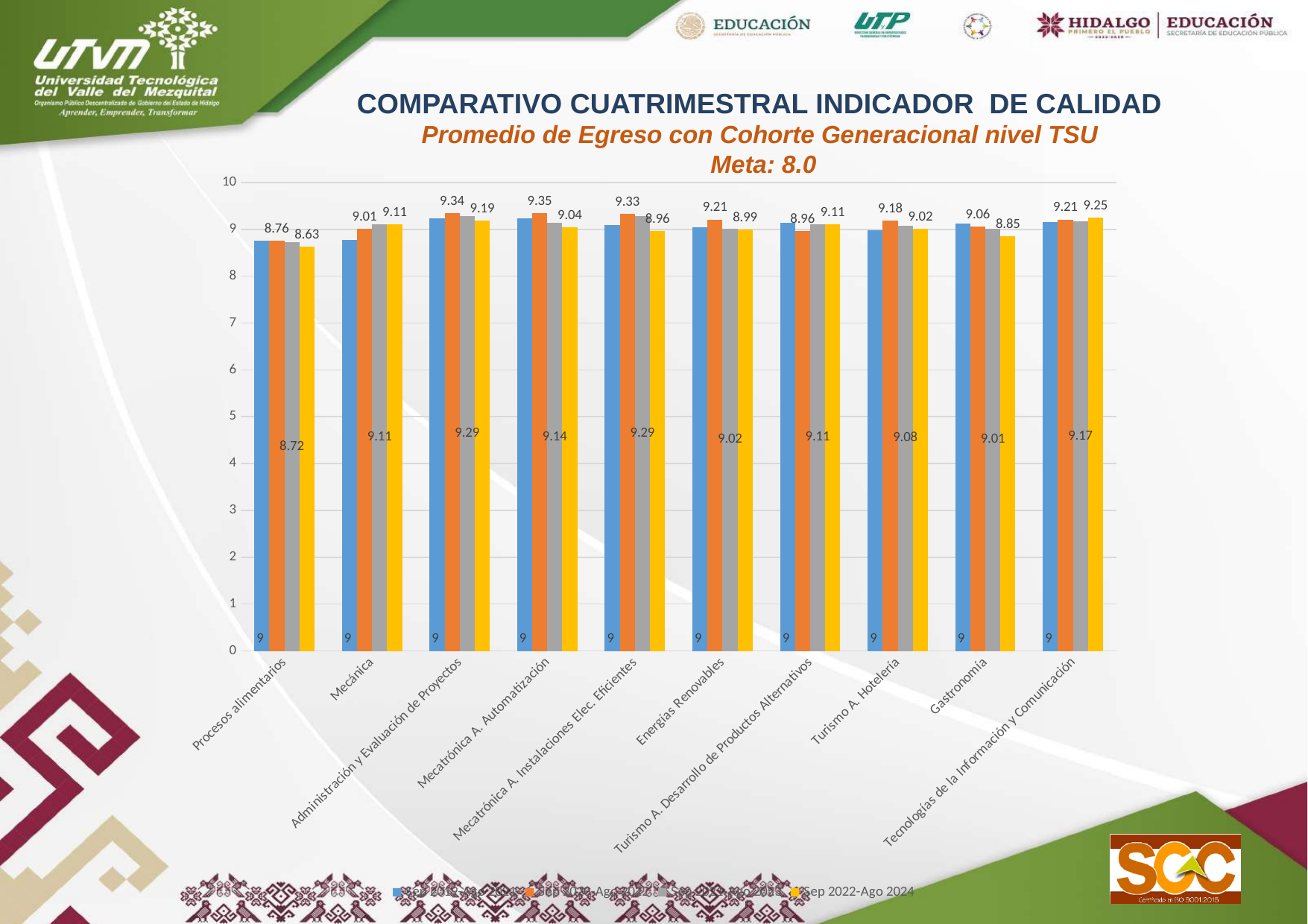
Which program has the lowest orange bar value? Procesos alimentarios What kind of chart is shown on the slide? bar chart Which program has the highest Sep 2022-Ago 2024 (yellow bar) value? Tecnologías de la Información y Comunicación What target (Meta) is stated in the chart title? 8.0 Which program has the lowest Sep 2022-Ago 2024 (yellow bar) value? Procesos alimentarios What is the Sep 2022-Ago 2024 (yellow bar) value for Tecnologías de la Información y Comunicación? 9.25 For Gastronomía, which is larger: the orange bar or the yellow bar? the orange bar What is the value of the orange bar for Mecatrónica A. Automatización? 9.35 What is the difference between the yellow bar values for Tecnologías de la Información y Comunicación and Procesos alimentarios? 0.62 How many programs (categories) are shown along the x axis of the chart? 10 What is the value of the gray bar for Procesos alimentarios? 8.72 Is the yellow bar value for Procesos alimentarios greater or less than 8? greater